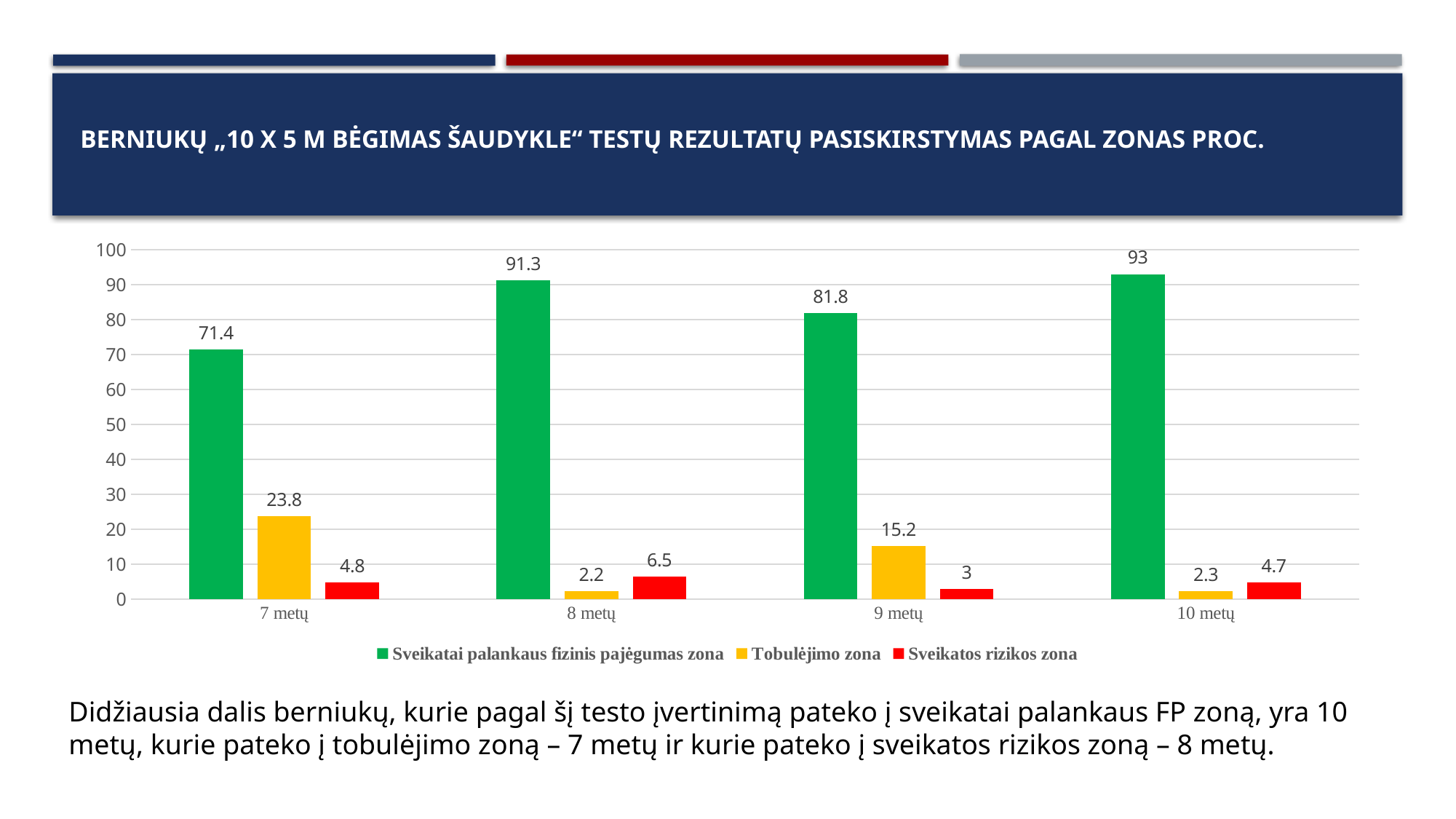
Which is larger: the "Sveikatos rizikos zona" value for 8 metų or for 10 metų? 8 metų What is the value for "Tobulėjimo zona" for 7 metų? 23.8 Which age group has the lowest value for "Tobulėjimo zona"? 8 metų What kind of chart is shown on the slide? bar chart What is the difference between the "Sveikatai palankaus fizinis pajėgumas zona" values for 10 metų and 7 metų? 21.6 Is the value for "Sveikatai palankaus fizinis pajėgumas zona" for 9 metų greater or less than 90? less What is the value for "Sveikatos rizikos zona" for 9 metų? 3 How many series does the legend list? 3 Which age group has the highest value for "Sveikatai palankaus fizinis pajėgumas zona"? 10 metų What is the value for "Sveikatai palankaus fizinis pajėgumas zona" for 8 metų? 91.3 What colour represents "Sveikatos rizikos zona" in the chart? red How many age groups are shown on the x axis? 4